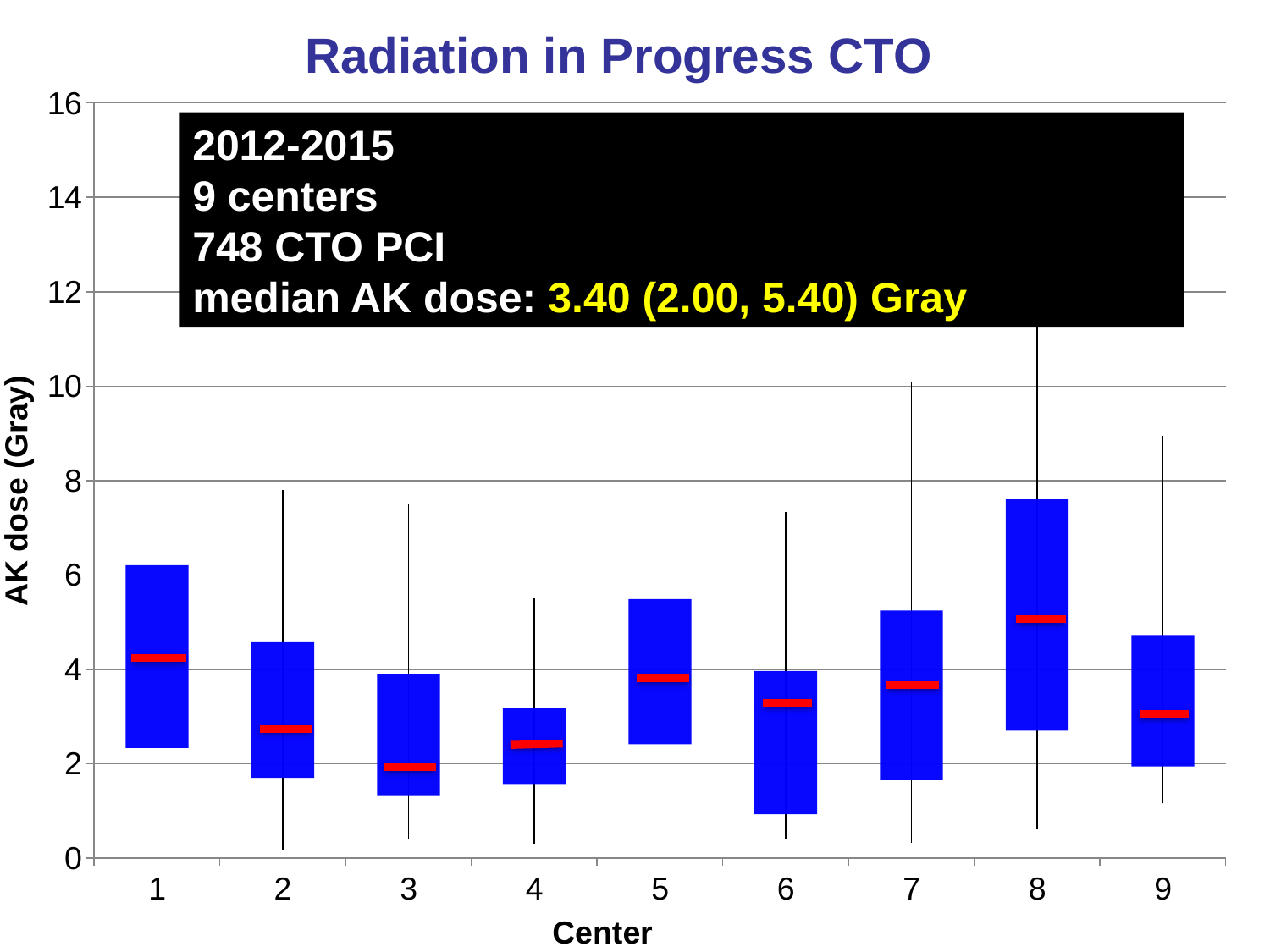
Which center has the highest upper whisker? 8 How many centers are plotted along the x axis? 9 Which center has the lowest median AK dose (red marker)? 3 Is the median AK dose for center 3 greater or less than 4 Gray? less What overall median AK dose is stated in the text box on the chart? 3.40 (2.00, 5.40) Gray Is the top of the box for center 8 greater or less than 6 Gray? greater What kind of chart is shown on the slide? box plot What is the title of the chart? Radiation in Progress CTO Is the median AK dose for center 8 greater or less than 4 Gray? greater Which center has the highest median AK dose (red marker)? 8 Which center has the larger median AK dose, center 8 or center 2? 8